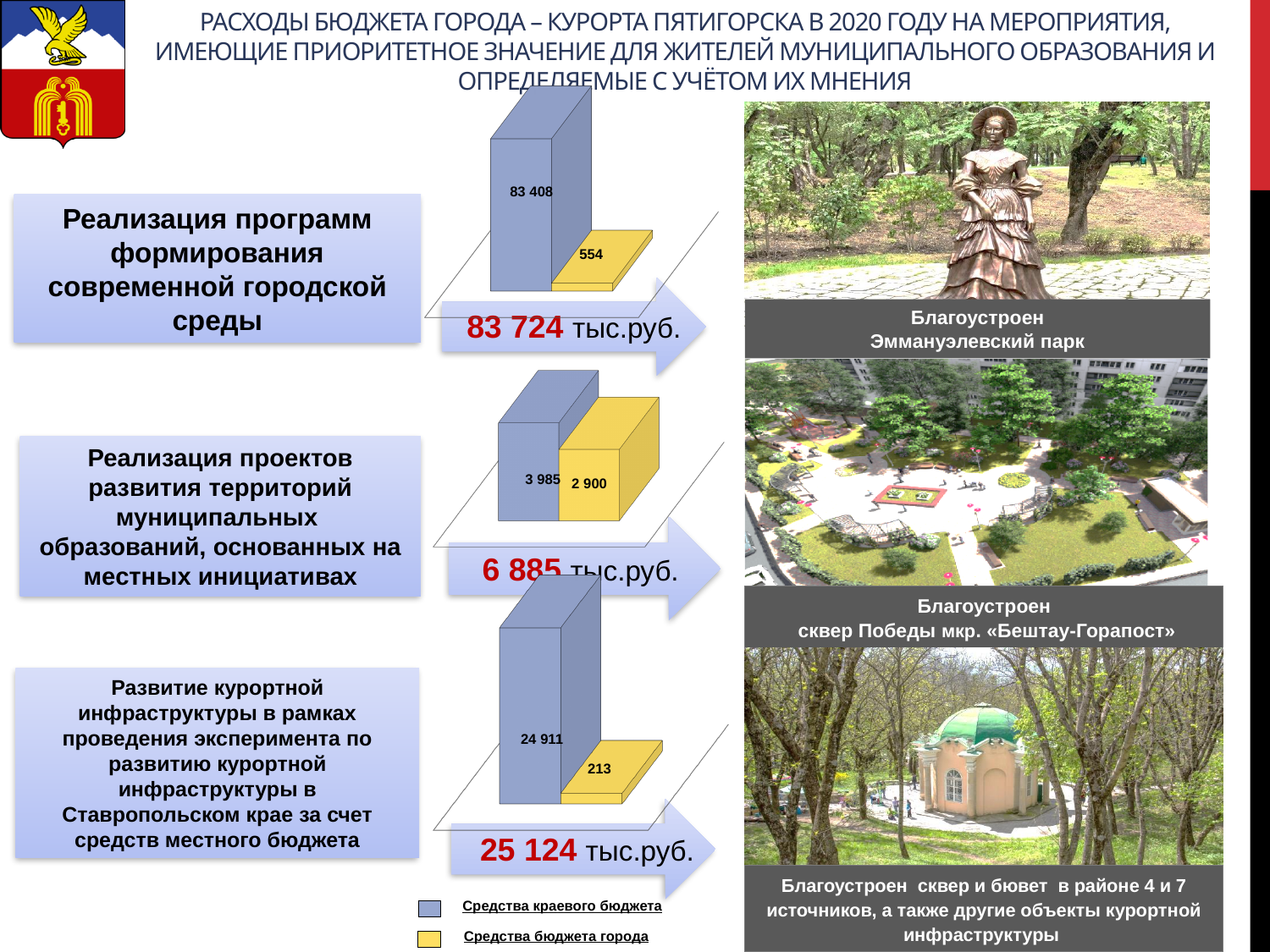
In the top chart (next to 'Реализация программ формирования современной городской среды'), what is the value for Средства краевого бюджета? 83 408 According to the legend, which colour represents Средства бюджета города? Yellow In the middle chart (next to 'Реализация проектов развития территорий муниципальных образований, основанных на местных инициативах'), what is the value for Средства краевого бюджета? 3 985 In the top chart, what is the difference between Средства краевого бюджета and Средства бюджета города? 82 854 How many series does the legend at the bottom of the slide list? 2 In the middle chart (next to 'Реализация проектов развития территорий муниципальных образований, основанных на местных инициативах'), what is the value for Средства бюджета города? 2 900 In the top chart (next to 'Реализация программ формирования современной городской среды'), what is the value for Средства бюджета города? 554 In the bottom chart (next to 'Развитие курортной инфраструктуры...'), what is the value for Средства бюджета города? 213 In the bottom chart (next to 'Развитие курортной инфраструктуры...'), what is the value for Средства краевого бюджета? 24 911 What kind of chart is used for the three charts in the middle of the slide? Bar chart In the middle chart, which is larger: Средства краевого бюджета or Средства бюджета города? Средства краевого бюджета In the bottom chart, what is the total of Средства краевого бюджета and Средства бюджета города, as printed on the slide? 25 124 тыс.руб.